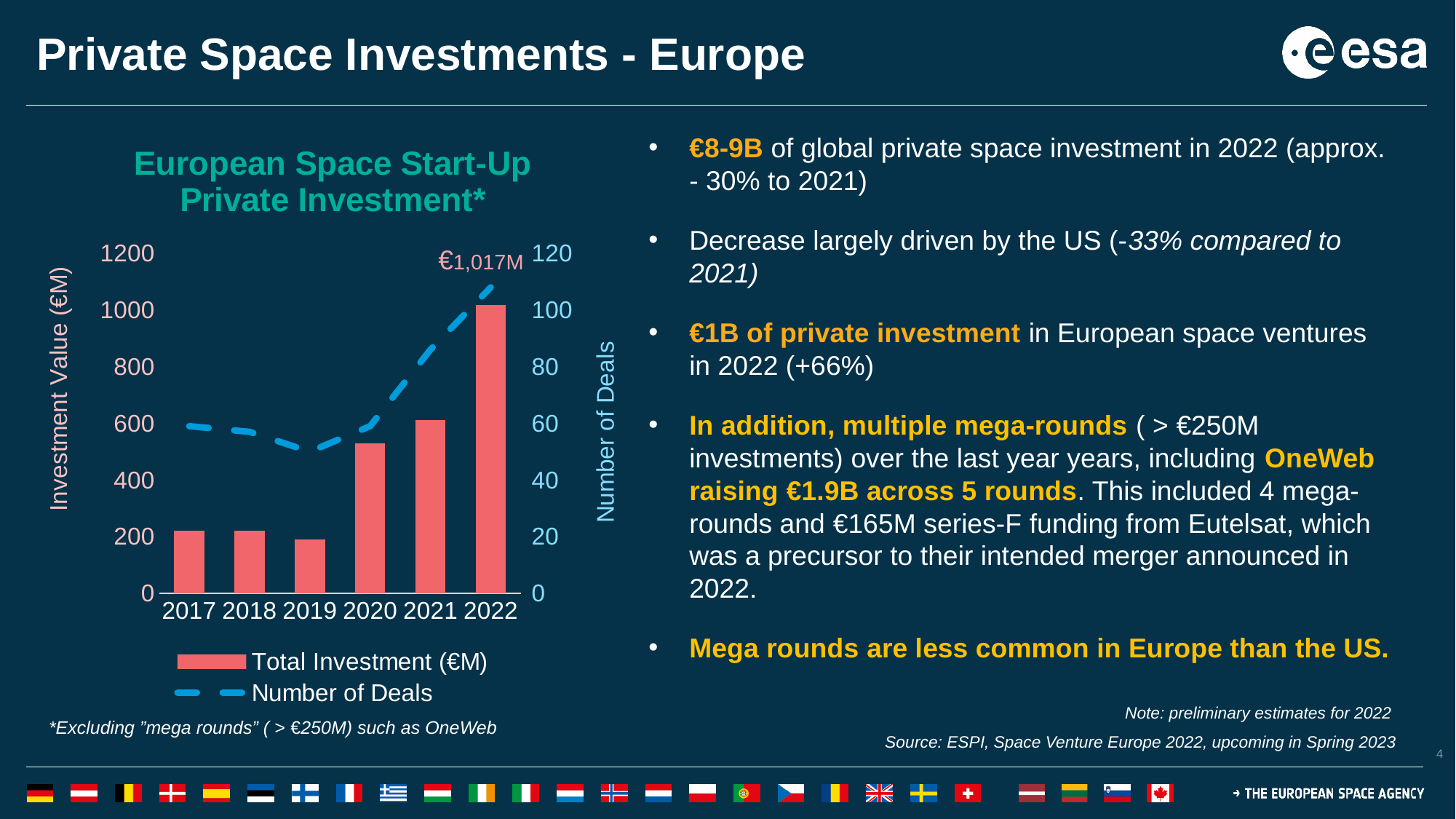
What kind of chart is this? Combined bar and line chart Is the total investment for 2020 greater or less than 400? greater Is the total investment for 2017 greater or less than 400? less Which year has the larger total investment, 2020 or 2021? 2021 Is the number of deals in 2019 greater or less than 60? less Which year has the lowest total investment? 2019 How many years are shown on the x axis? 6 Which year has the highest total investment? 2022 What is the total investment value shown for 2022? €1,017M What is the label of the right-hand vertical axis? Number of Deals How many series does the legend list? 2